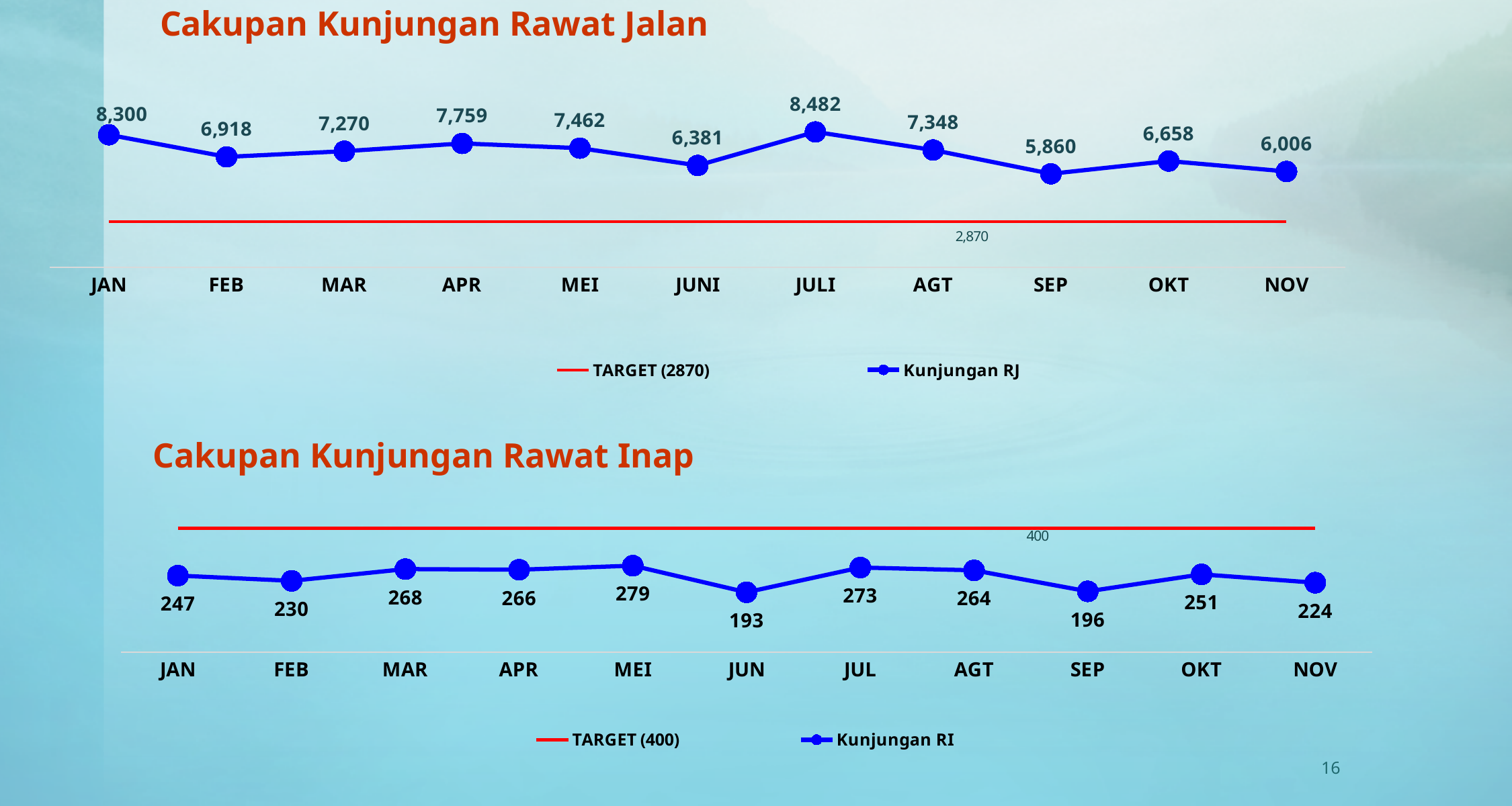
In the 'Cakupan Kunjungan Rawat Inap' chart, what colour is the TARGET (400) line? Red What type of chart is the 'Cakupan Kunjungan Rawat Inap' chart? Line chart In the 'Cakupan Kunjungan Rawat Inap' chart, which month has the highest Kunjungan RI value? MEI In the 'Cakupan Kunjungan Rawat Jalan' chart, what is the target value shown by the red line? 2,870 In the 'Cakupan Kunjungan Rawat Inap' chart, what is the difference between the MEI and JUN Kunjungan RI values? 86 In the 'Cakupan Kunjungan Rawat Jalan' chart, which is larger, the Kunjungan RJ value for MAR or for MEI? MEI In the 'Cakupan Kunjungan Rawat Jalan' chart, what is the difference between the JAN and NOV Kunjungan RJ values? 2,294 In the 'Cakupan Kunjungan Rawat Jalan' chart, what is the Kunjungan RJ value for JULI? 8,482 In the 'Cakupan Kunjungan Rawat Jalan' chart, how many months are plotted on the x axis? 11 In the 'Cakupan Kunjungan Rawat Inap' chart, how many series does the legend list? 2 In the 'Cakupan Kunjungan Rawat Inap' chart, what is the Kunjungan RI value for JUN? 193 In the 'Cakupan Kunjungan Rawat Jalan' chart, which month has the lowest Kunjungan RJ value? SEP